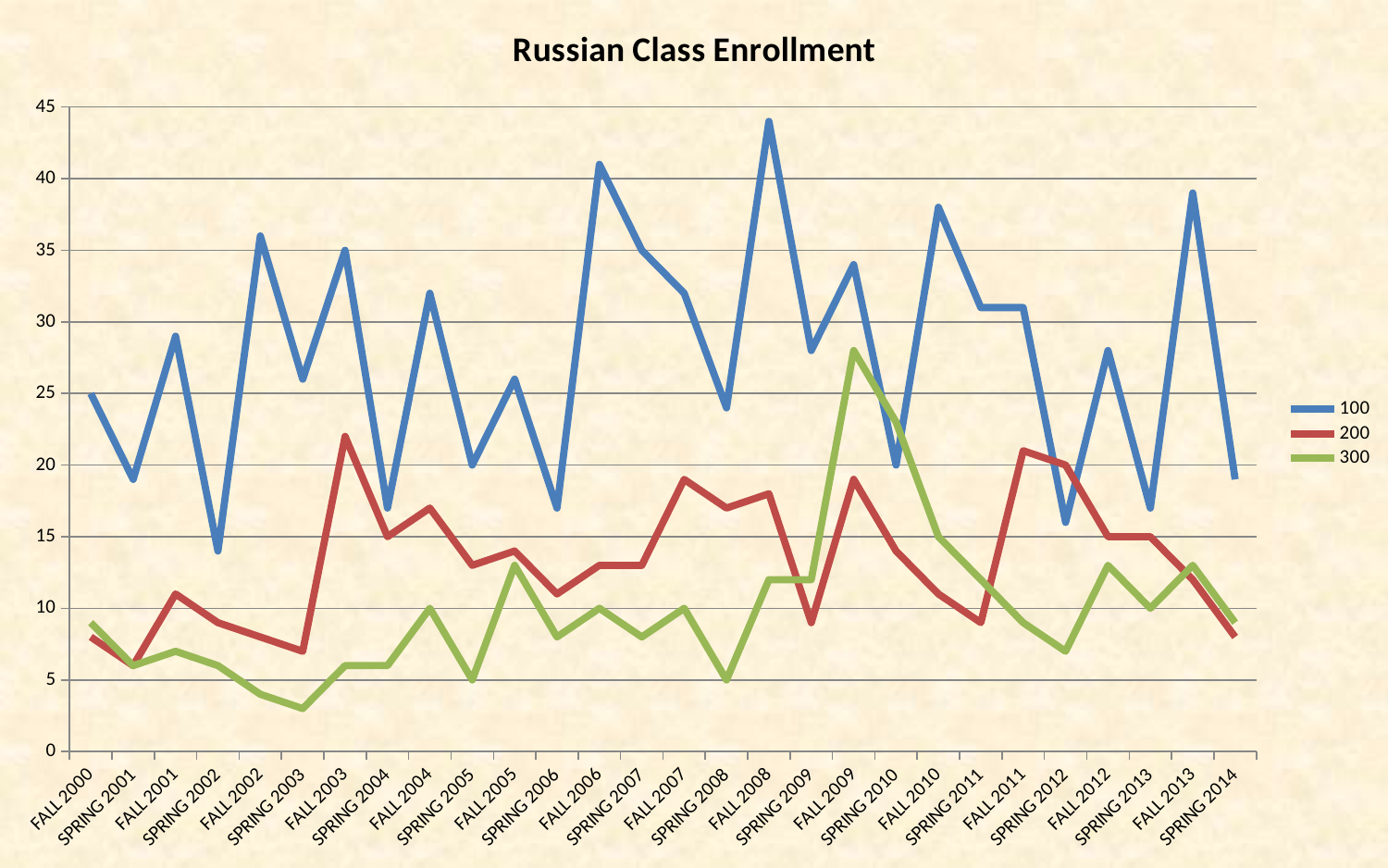
In which semester does the 300 series reach its highest value? FALL 2009 What kind of chart is shown on the slide? line chart Is the value of the 100 series in FALL 2008 greater or less than 40? greater In SPRING 2010, which series has the larger value, 200 or 300? 300 What are the three series named in the legend? 100, 200, 300 How many series does the legend list? 3 Does the 100 series rise or fall from FALL 2013 to SPRING 2014? fall What is the title of the chart? Russian Class Enrollment In which semester does the 100 series reach its lowest value? SPRING 2002 In which semester does the 100 series reach its highest value? FALL 2008 Is the value of the 300 series in FALL 2009 greater or less than 25? greater How many semesters (categories) are plotted along the x axis? 28